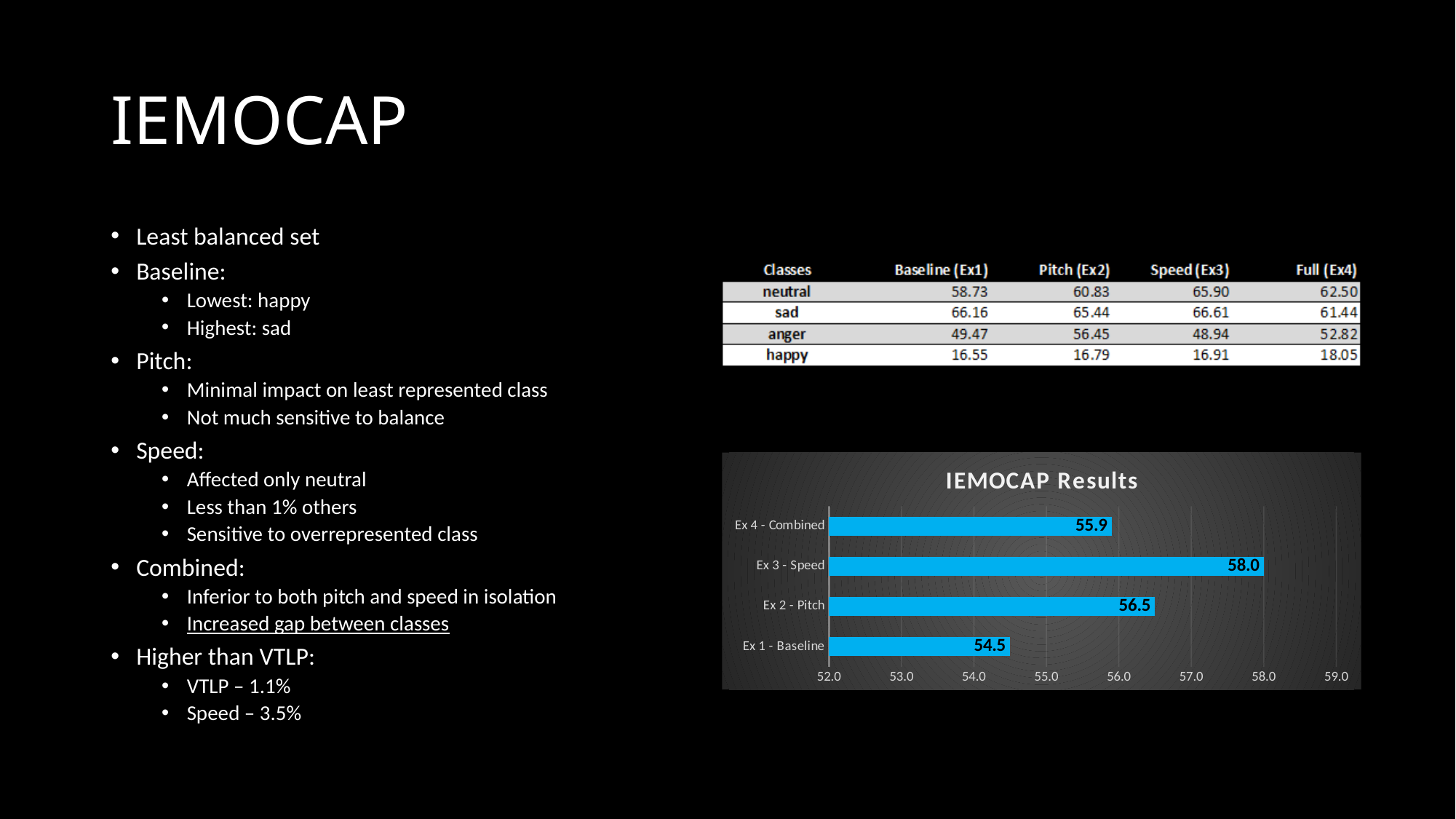
How many categories are shown in the IEMOCAP Results chart? 4 What is the value for Ex 3 - Speed in the IEMOCAP Results chart? 58.0 In the IEMOCAP Results chart, which is larger: Ex 2 - Pitch or Ex 4 - Combined? Ex 2 - Pitch Which category has the lowest value in the IEMOCAP Results chart? Ex 1 - Baseline What kind of chart is the IEMOCAP Results chart? Bar chart What is the difference between the values for Ex 2 - Pitch and Ex 4 - Combined in the IEMOCAP Results chart? 0.6 What is the value for Ex 1 - Baseline in the IEMOCAP Results chart? 54.5 Which category has the highest value in the IEMOCAP Results chart? Ex 3 - Speed What is the value for Ex 4 - Combined in the IEMOCAP Results chart? 55.9 What is the difference between the values for Ex 3 - Speed and Ex 1 - Baseline in the IEMOCAP Results chart? 3.5 What is the title of the chart on the slide? IEMOCAP Results What is the value for Ex 2 - Pitch in the IEMOCAP Results chart? 56.5